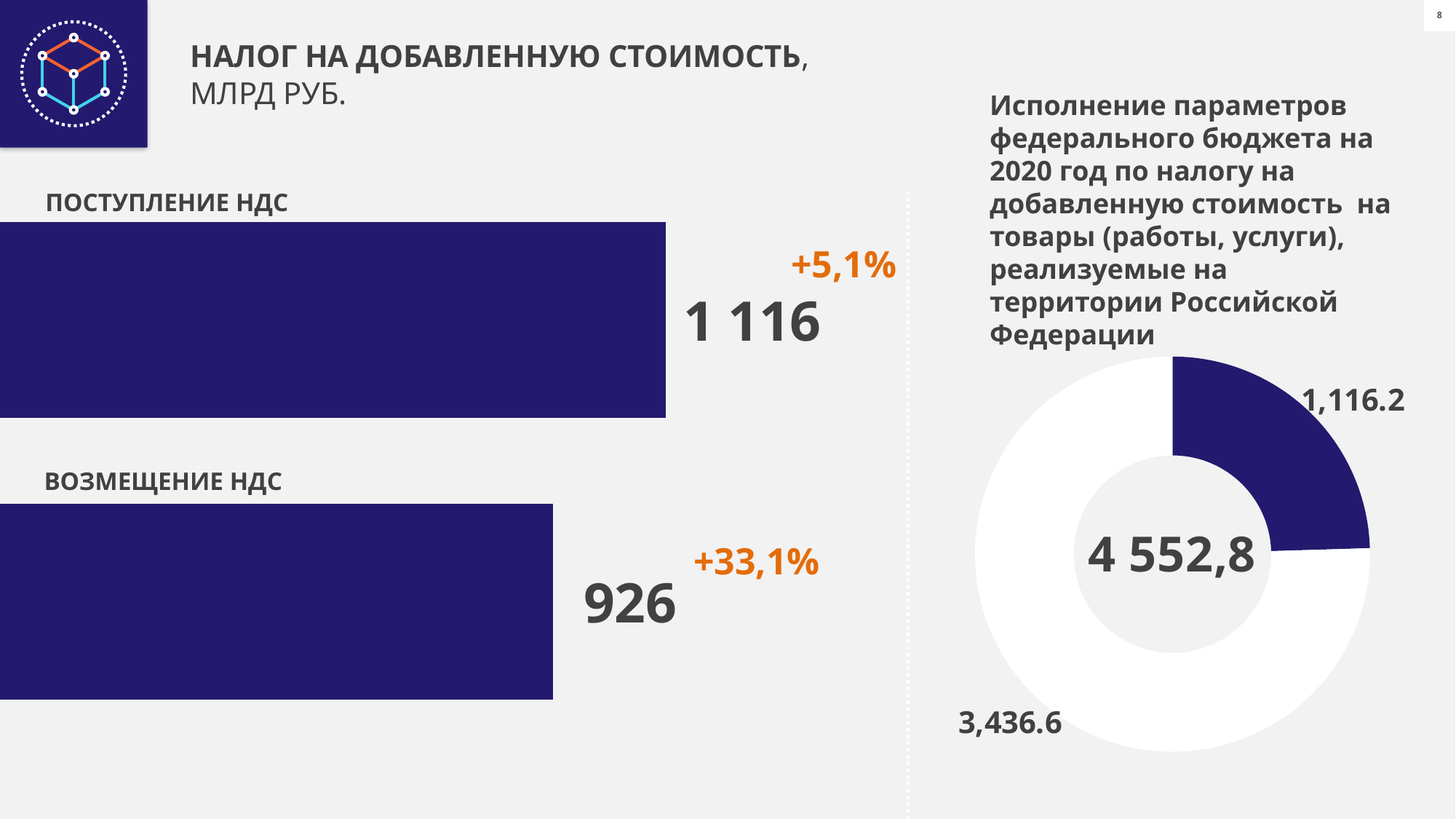
On the left bar chart, which category has the higher value, ПОСТУПЛЕНИЕ НДС or ВОЗМЕЩЕНИЕ НДС? ПОСТУПЛЕНИЕ НДС On the left bar chart, what is the value for ПОСТУПЛЕНИЕ НДС? 1 116 On the left bar chart, how many bars are shown? 2 On the left bar chart, what percentage change is shown next to ПОСТУПЛЕНИЕ НДС? +5,1% On the left bar chart, what is the value for ВОЗМЕЩЕНИЕ НДС? 926 On the left bar chart, what percentage change is shown next to ВОЗМЕЩЕНИЕ НДС? +33,1% On the right donut chart, what value is labelled on the dark blue segment? 1,116.2 On the right donut chart, what total is shown in the centre? 4 552,8 On the left bar chart, what is the difference between the values for ПОСТУПЛЕНИЕ НДС and ВОЗМЕЩЕНИЕ НДС? 190 What kind of chart is shown on the right side of the slide? Donut chart On the right donut chart, what value is labelled on the white segment? 3,436.6 What kind of chart is shown on the left side of the slide? Bar chart